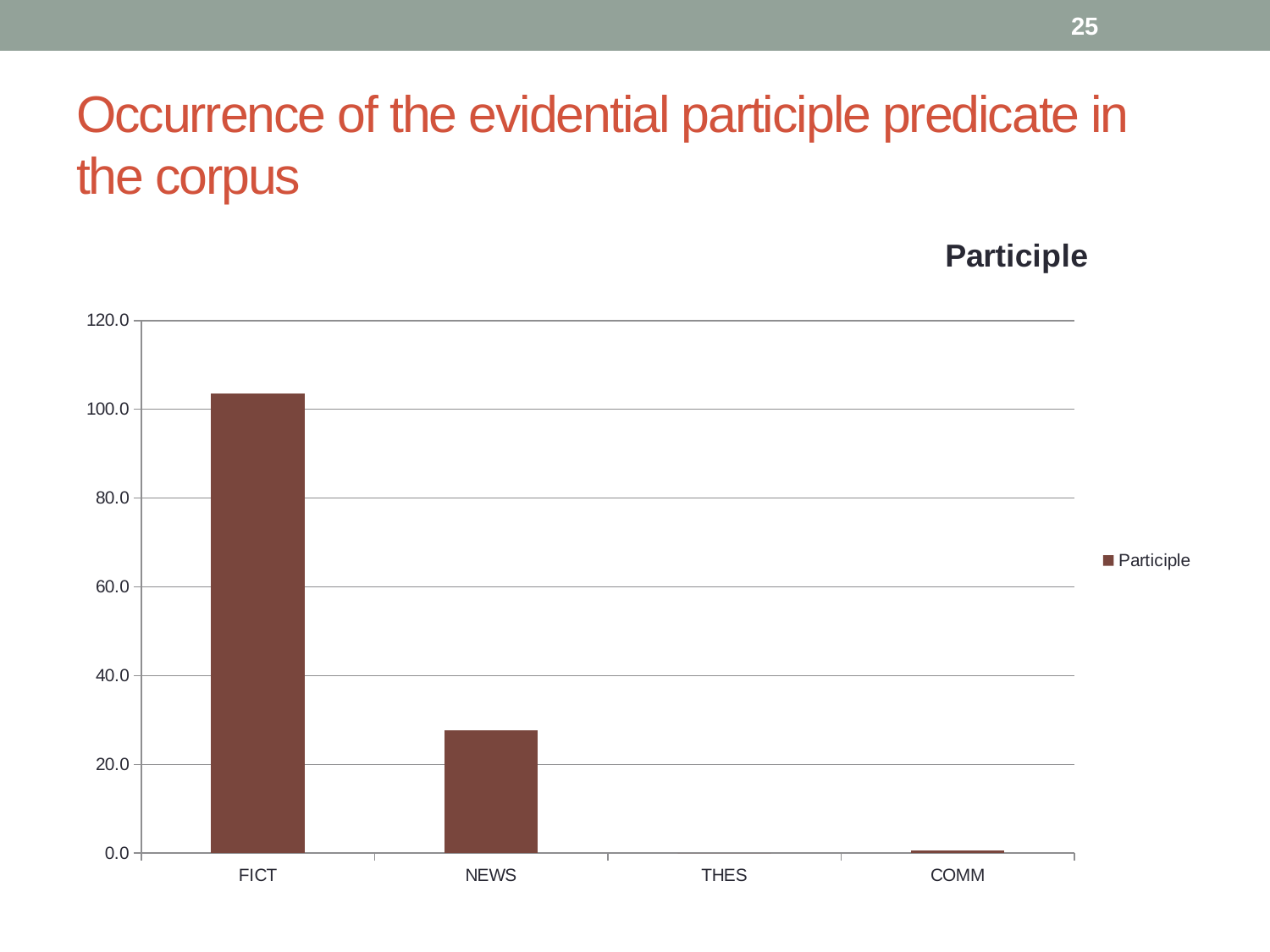
Is the value for COMM greater or less than 20.0? less Is the value for NEWS greater or less than 20.0? greater Which category has the highest value? FICT How many categories are shown on the x axis? 4 How many series does the legend list? 1 What is the title of the chart? Participle What is the name of the series shown in the legend? Participle Is the value for FICT greater or less than 100.0? greater What type of chart is shown on the slide? bar chart Which category has the lowest value? THES Which is larger, the value for FICT or the value for NEWS? FICT